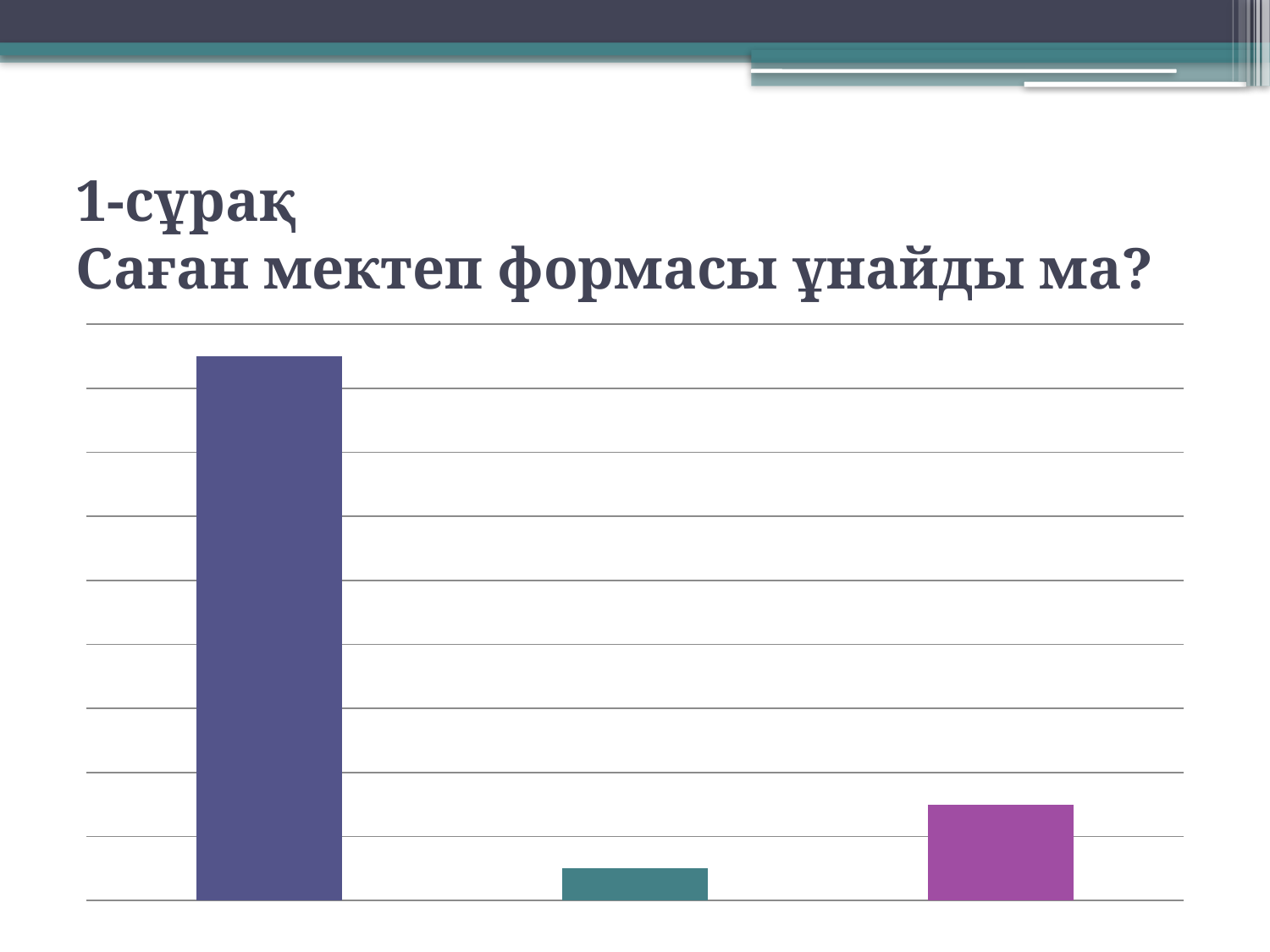
Which is taller, the middle bar or the right bar? right bar What colour is the tallest bar in the chart? purple Which bar is the shortest in the chart: the left, middle or right one? middle What question is written as the title above the chart? Саған мектеп формасы ұнайды ма? Which bar is the tallest in the chart: the left, middle or right one? left Which is taller, the left bar or the right bar? left bar What kind of chart is shown on the slide? bar chart How many bars are plotted in the chart? 3